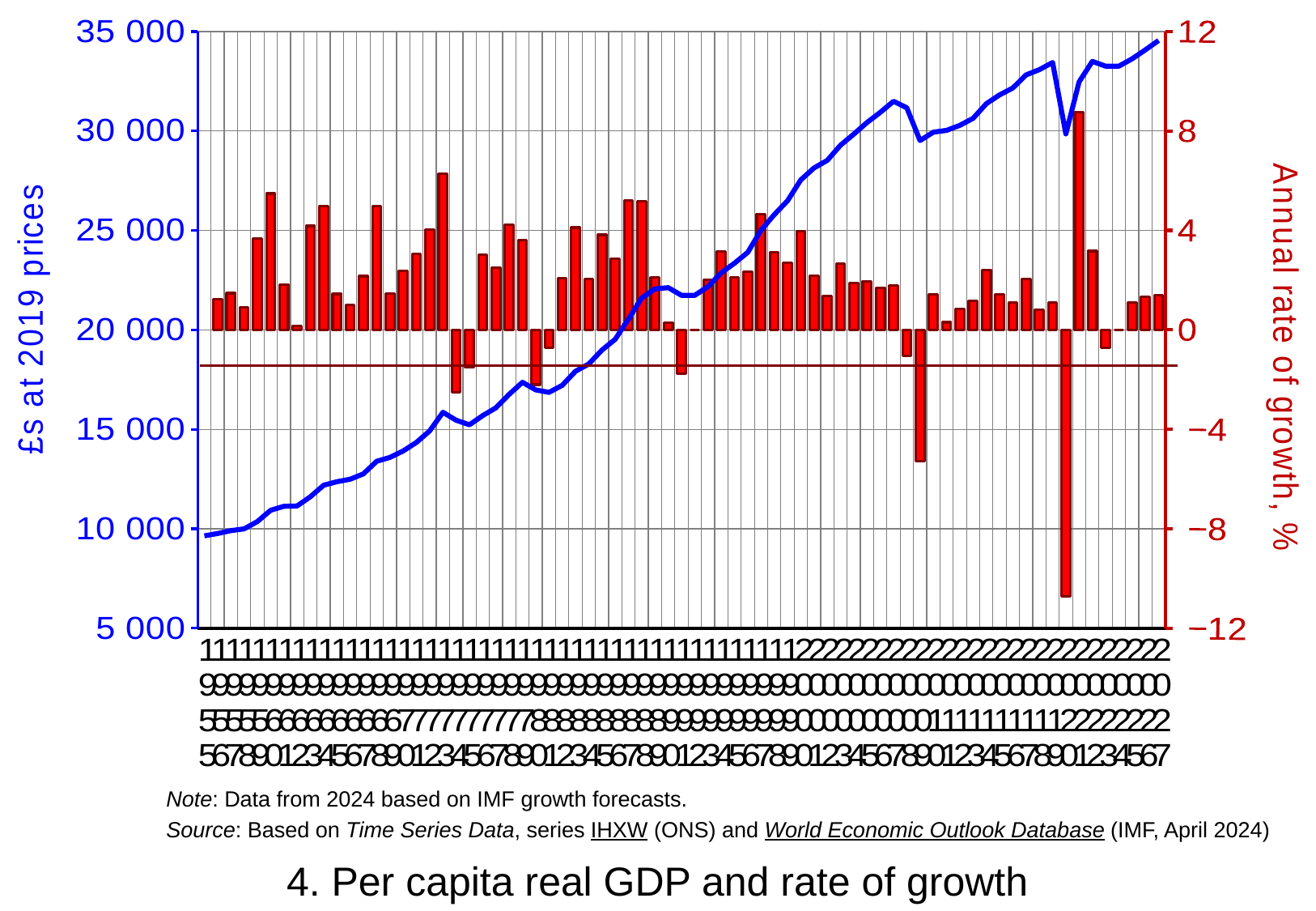
What is the label of the right-hand vertical axis? Annual rate of growth, % Which year has the lowest annual rate of growth (red bars)? 2020 Is per capita real GDP (blue line) higher in 2007 or in 2009? 2007 Which year has the highest annual rate of growth (red bars)? 2021 What kind of chart is shown on the slide? A combined bar and line chart Is the per capita real GDP (blue line) in 1955 greater or less than 10 000? less Does per capita real GDP (blue line) generally rise or fall from 1955 to 2027? rise Is the annual rate of growth in 2009 greater or less than -4? less Is the annual rate of growth in 2020 greater or less than -8? less What is the title of the chart? 4. Per capita real GDP and rate of growth